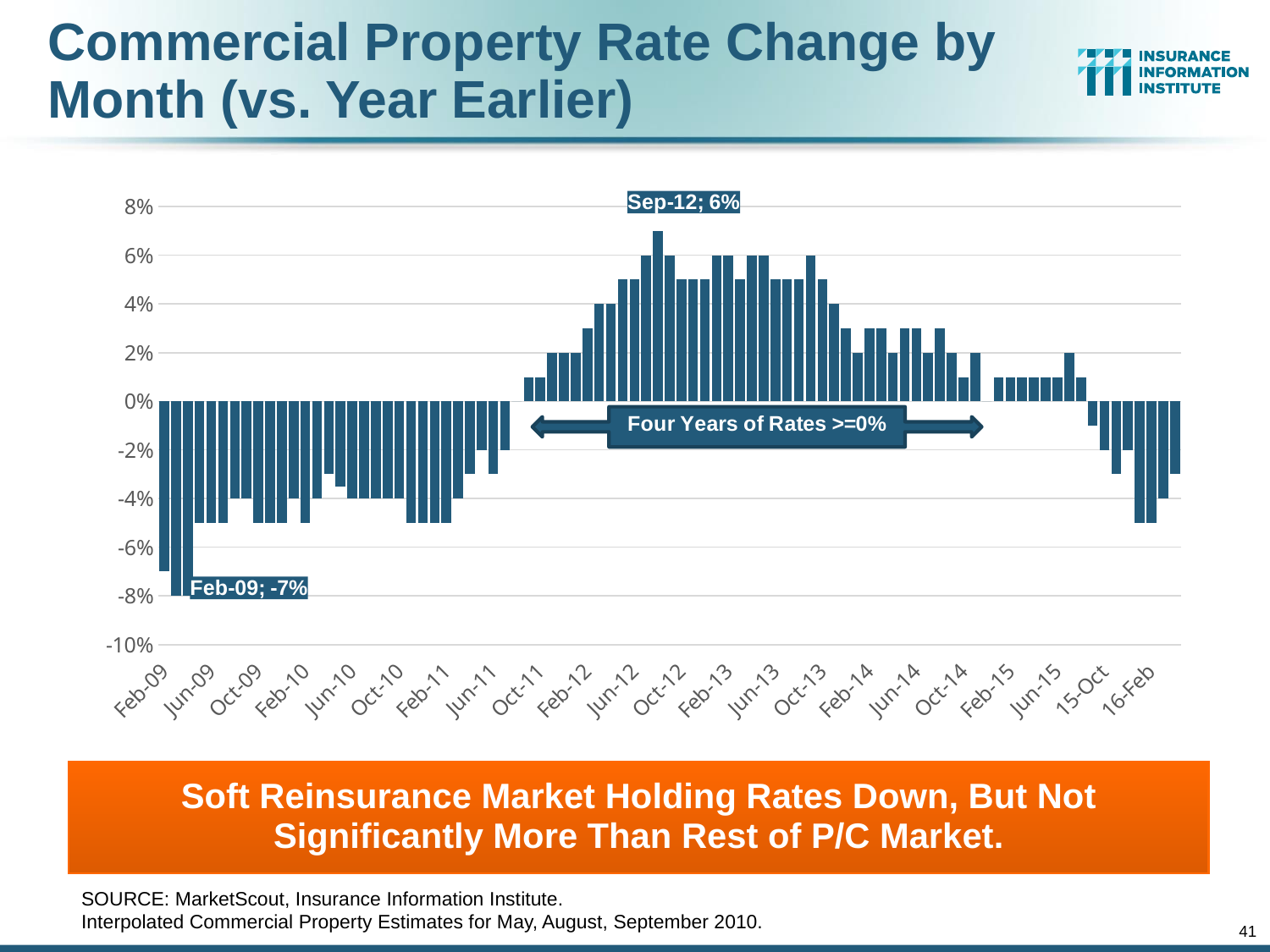
Is the value for Jun-09 greater or less than -4%? less What is the difference between the labeled values for Sep-12 (6%) and Feb-09 (-7%)? 13 percentage points According to the data label, what is the rate change for Sep-12? 6% What does the annotation with arrows in the middle of the chart say? Four Years of Rates >=0% According to the data label, what is the rate change for Feb-09? -7% Do the values generally rise or fall from Feb-09 to Sep-12? rise What is the title of the chart on the slide? Commercial Property Rate Change by Month (vs. Year Earlier) Is the value for Feb-09 greater or less than -6%? less What kind of chart is shown on the slide? bar chart Which is larger, the labeled rate change for Feb-09 or for Sep-12? Sep-12